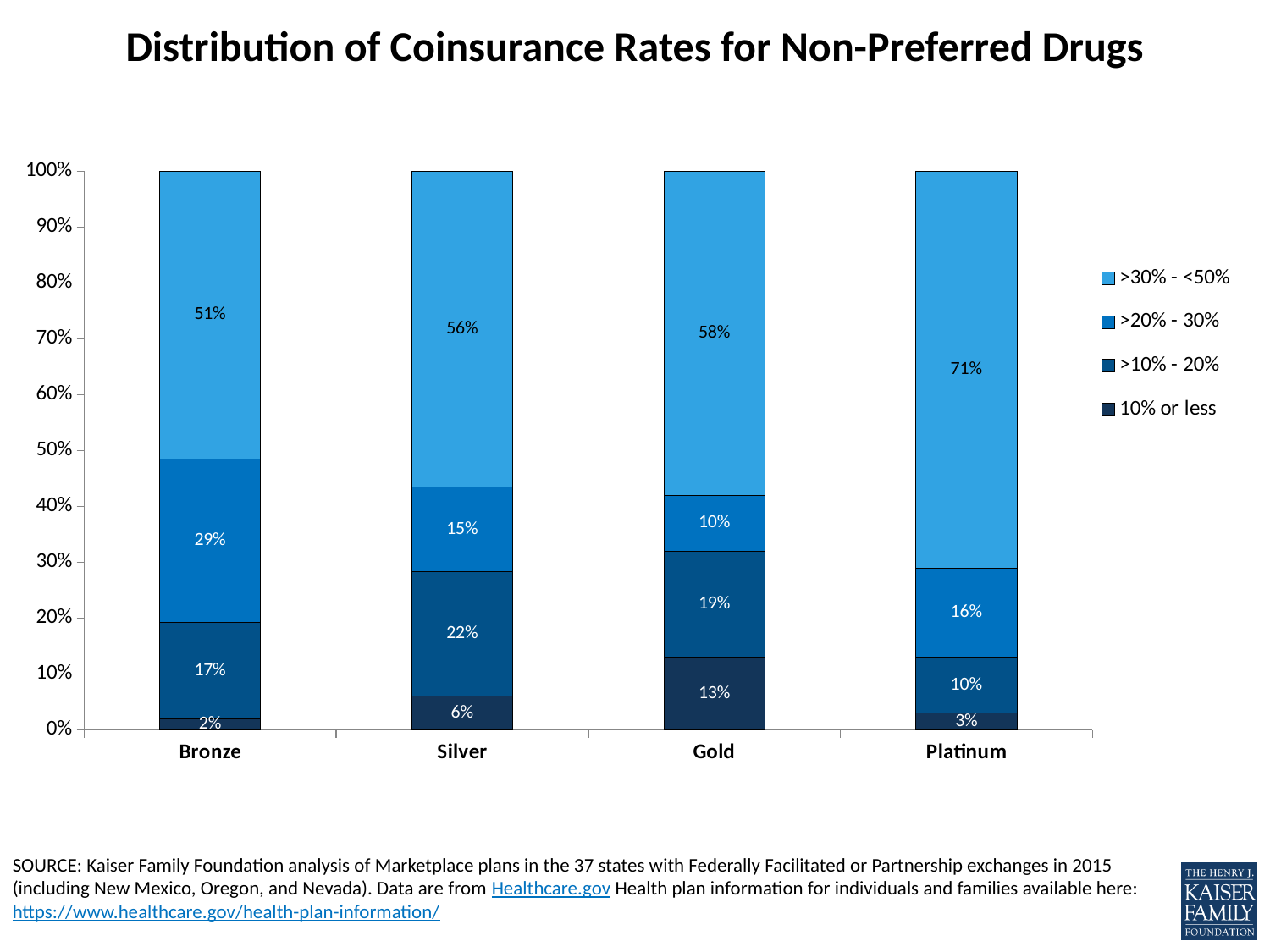
What is the difference between the >30% - <50% share for Platinum and for Bronze? 20 percentage points What share of Gold plans have a coinsurance rate of 10% or less? 13% What kind of chart is shown on the slide? Stacked bar chart How many metal tiers (categories) are shown on the x axis? 4 What share of Platinum plans have a coinsurance rate of >20% - 30%? 16% Which metal tier has the highest share of plans in the >30% - <50% coinsurance range? Platinum How many series does the legend list? 4 What share of Silver plans have a coinsurance rate of >10% - 20%? 22% Which is larger: the >20% - 30% share for Bronze or for Gold? Bronze What is the title of the chart? Distribution of Coinsurance Rates for Non-Preferred Drugs What share of Bronze plans have a coinsurance rate of >30% - <50%? 51% Which metal tier has the lowest share of plans with coinsurance of 10% or less? Bronze